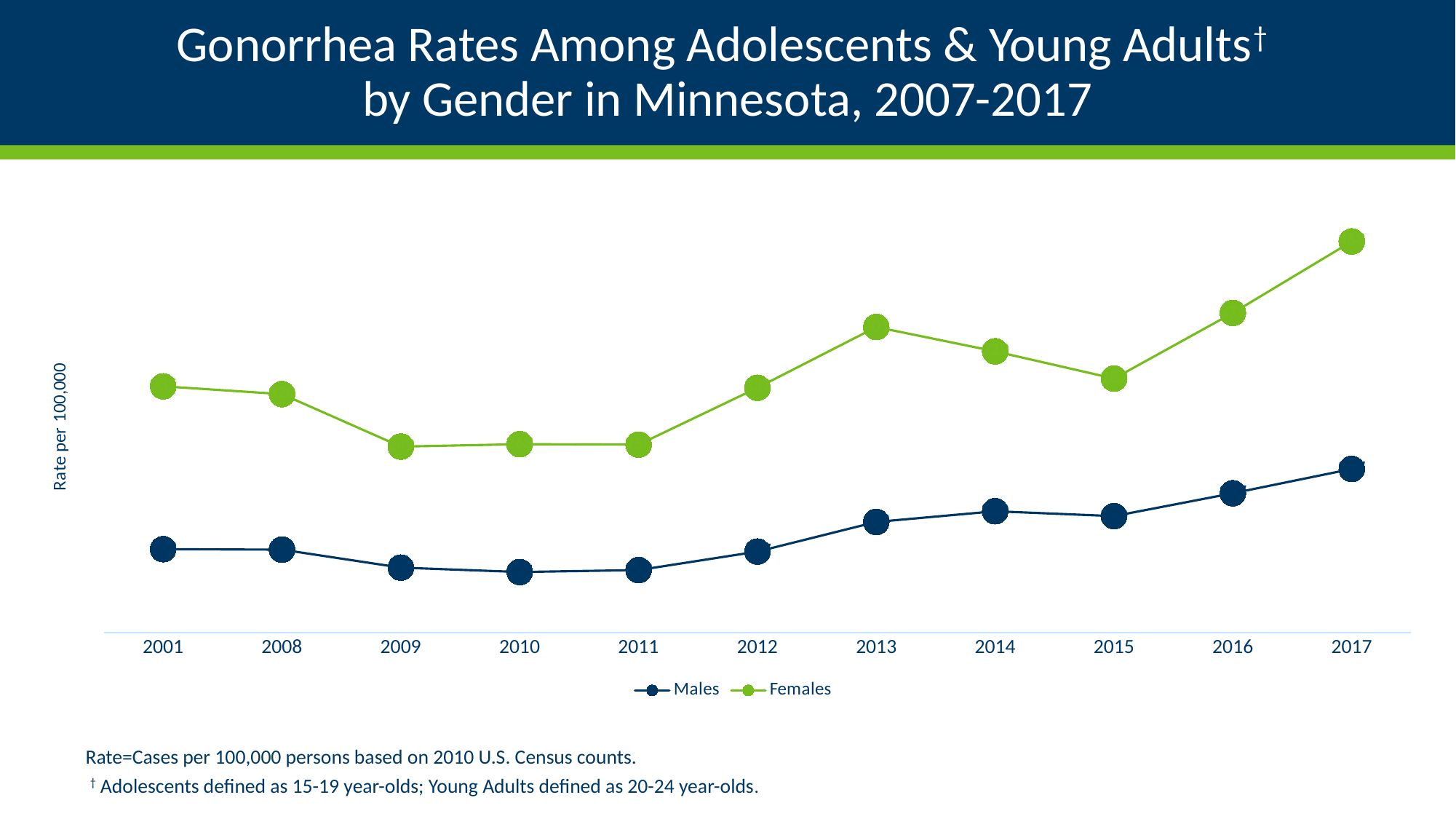
Which series has the lower rate in 2009, Males or Females? Males Does the Females rate rise or fall from 2013 to 2015? Fall Does the Males rate rise or fall from 2011 to 2014? Rise Does the Females rate rise or fall from 2015 to 2017? Rise What kind of chart is shown on the slide? Line chart Which colour is used for the Females series? Green How many years are plotted along the x axis? 11 How many series does the legend list? 2 In which year is the Females rate highest? 2017 What is the label on the y axis? Rate per 100,000 Which series has the higher rate in 2013, Males or Females? Females In which year is the Males rate highest? 2017